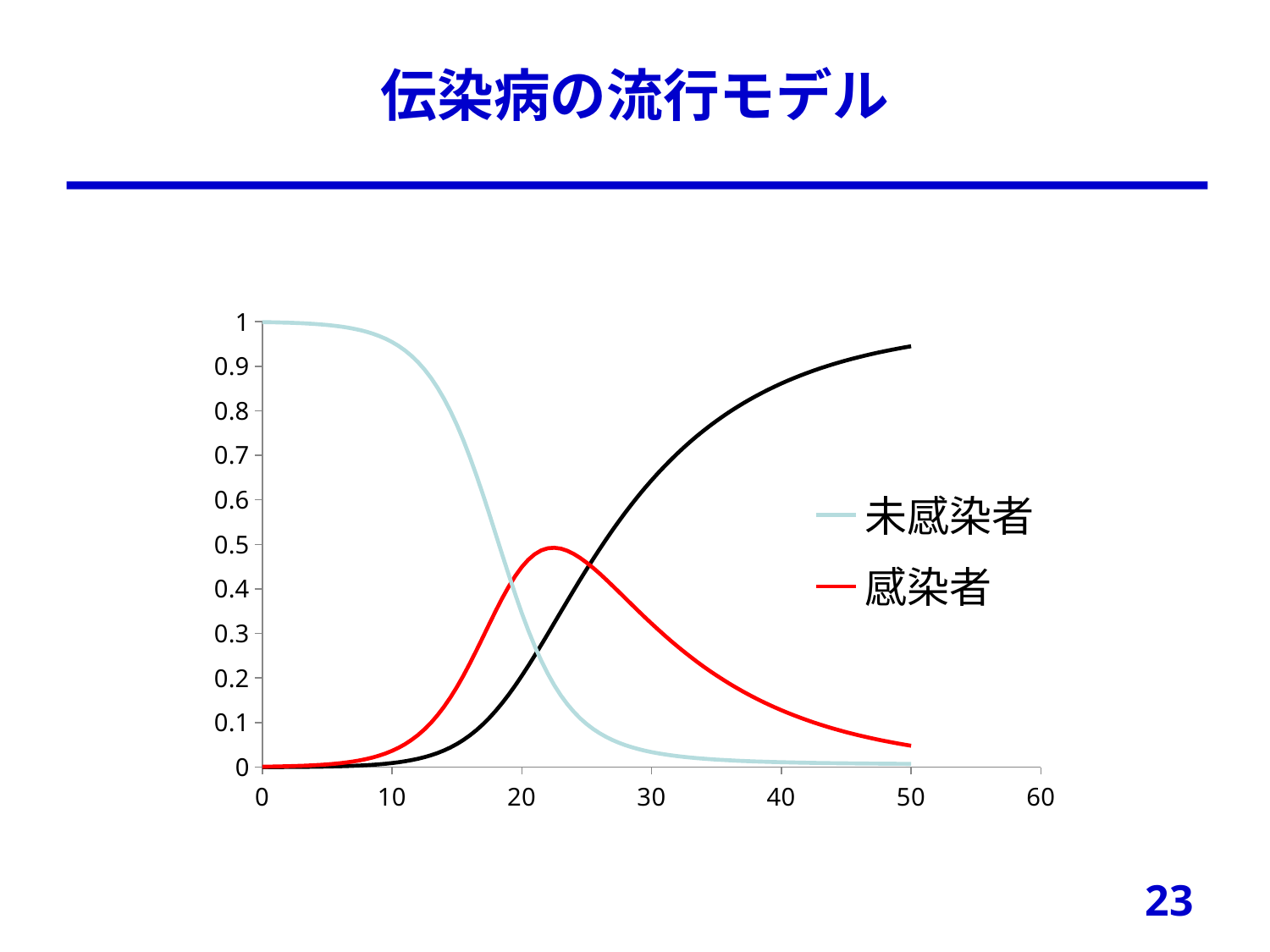
Does the 未感染者 line rise or fall as x increases? fall What kind of chart is shown on the slide? line chart Is the value of 未感染者 at x = 10 greater or less than 0.9? greater How many series does the legend list? 2 At x = 10, which is higher, 感染者 or 未感染者? 未感染者 At x = 40, which is higher, 感染者 or 未感染者? 感染者 Is the value of 感染者 at x = 50 greater or less than 0.1? less What is the title of the chart on the slide? 伝染病の流行モデル What colour is the line for 感染者? red Is the peak value of 感染者 greater or less than 0.4? greater